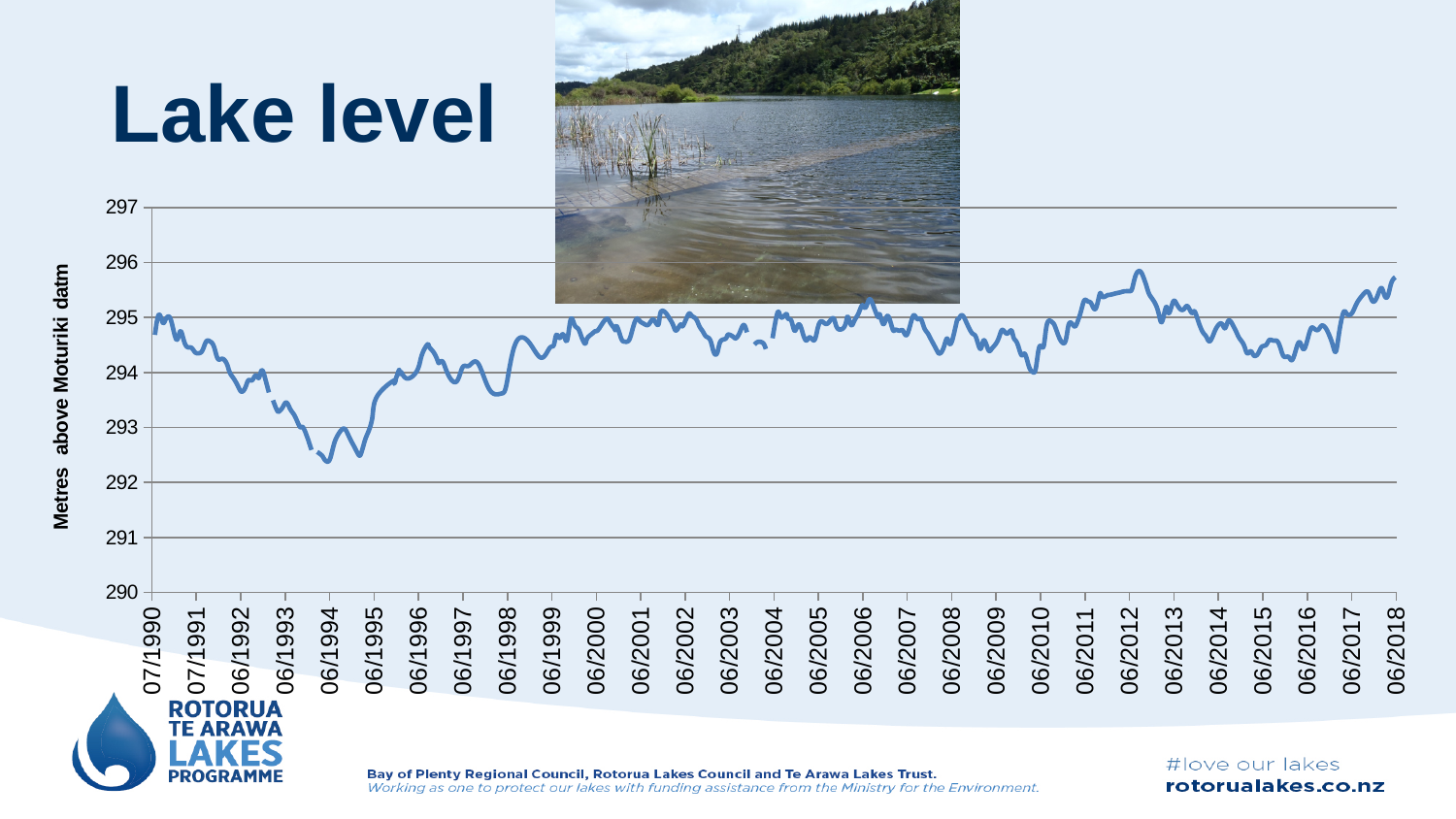
What kind of chart is shown on the slide? line chart Does the lake level rise or fall between 07/1990 and 06/1994? fall Is the lake level at 06/2018 greater or less than 295? greater What is the label on the vertical axis of the chart? Metres above Moturiki datm Does the lake level rise or fall overall between 06/1994 and 06/2018? rise Is the lake level at 07/1990 greater or less than 294? greater Is the lake level at 06/1994 greater or less than 293? less In which year does the lake level reach its lowest point on the chart? 1994 How many lines (data series) are plotted on the chart? 1 What is the title of the chart on the slide? Lake level